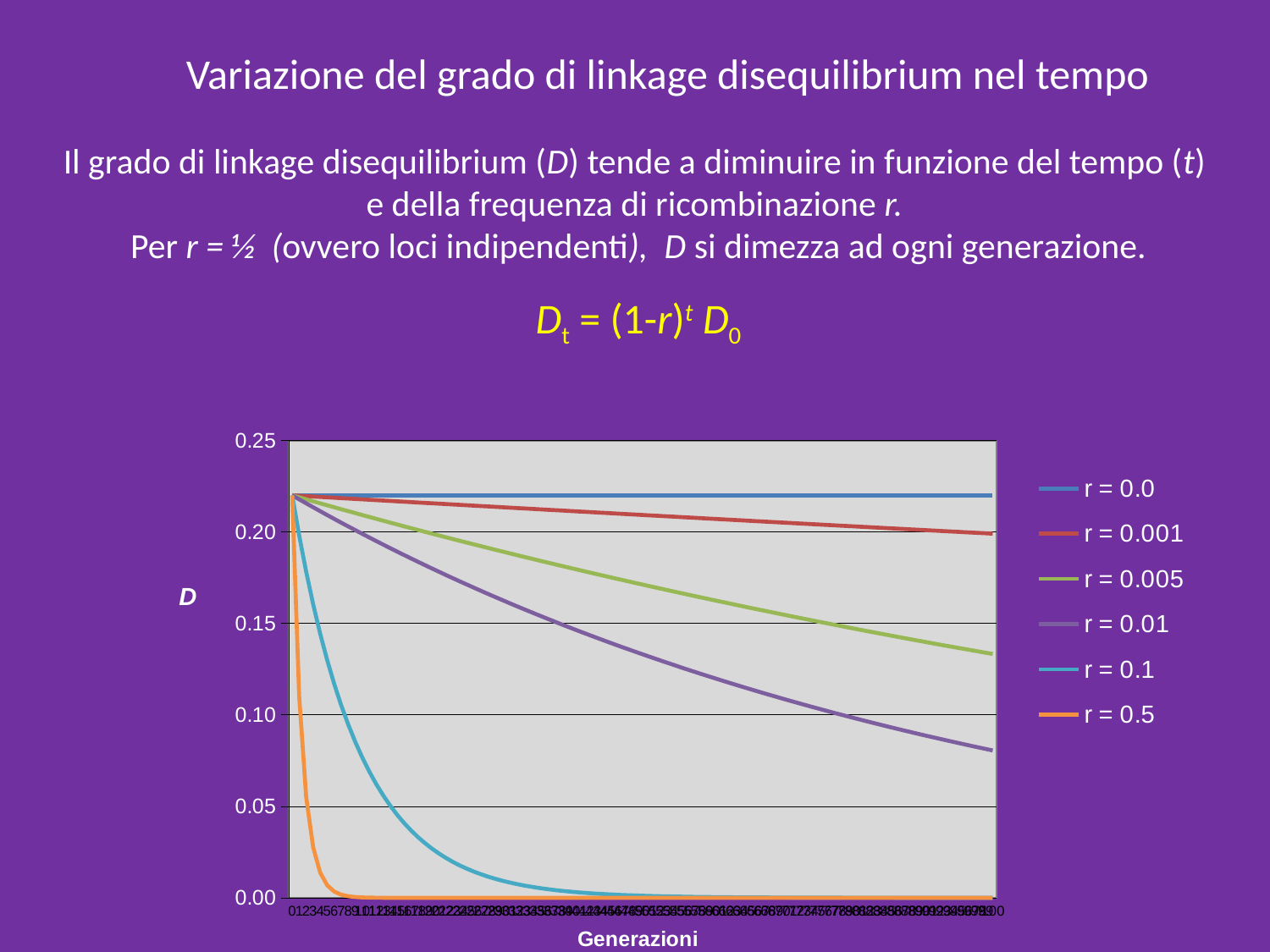
Is the value of the r = 0.01 series at generation 100 greater or less than 0.10? less What kind of chart is shown on the slide? line chart Does the r = 0.0 series rise, fall or stay flat as the generations increase? stay flat Which series has the highest value at generation 100? r = 0.0 Is the starting value of the series at generation 0 greater or less than 0.20? greater What is the label of the y axis of the chart? D Does the r = 0.5 series rise or fall as the generations increase? fall How many series does the chart legend list? 6 Is the value of the r = 0.005 series at generation 100 greater or less than 0.15? less At generation 100, which series has the higher value, r = 0.001 or r = 0.01? r = 0.001 What is the label of the x axis of the chart? Generazioni